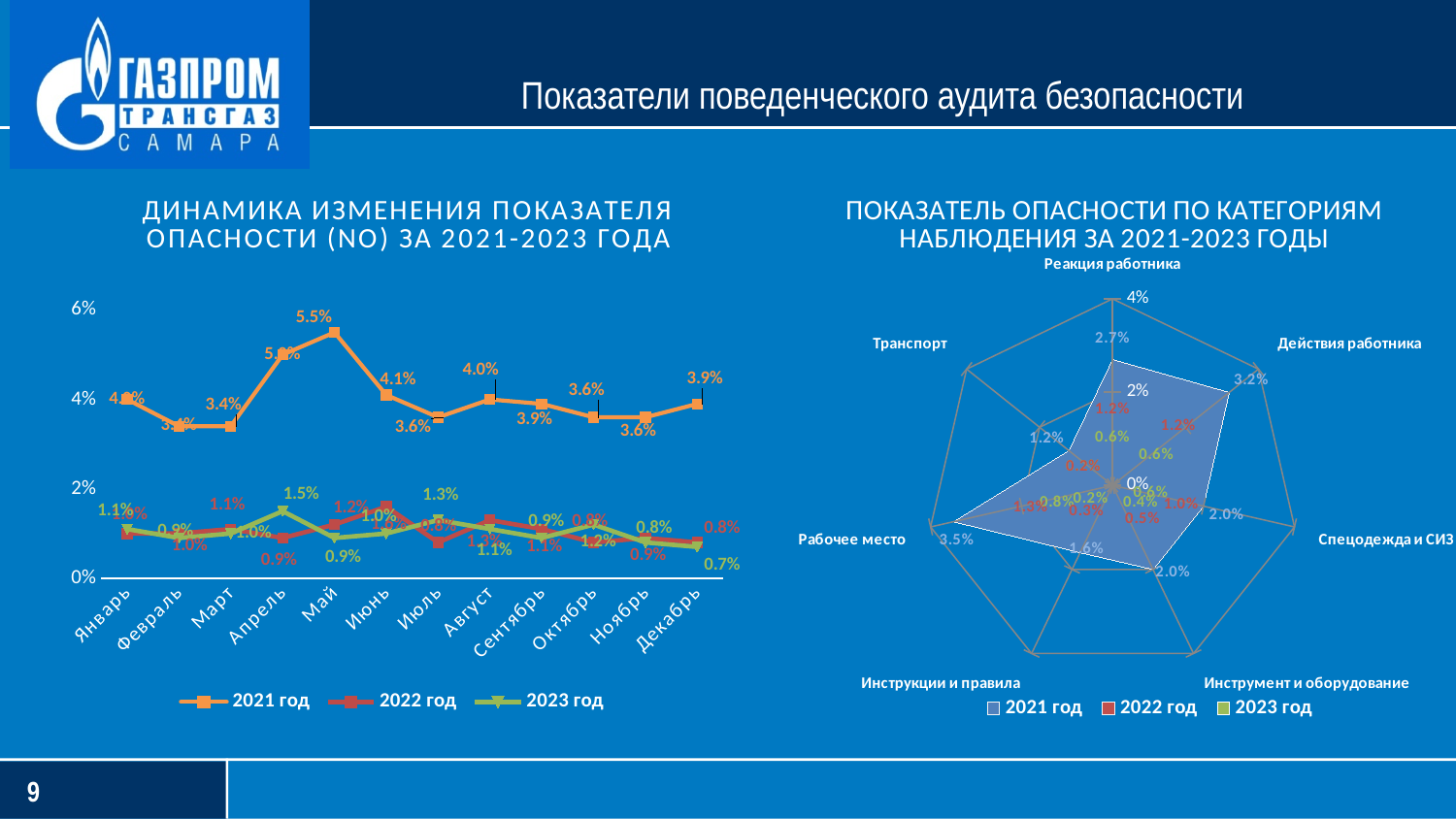
What kind of chart is the right chart, 'ПОКАЗАТЕЛЬ ОПАСНОСТИ ПО КАТЕГОРИЯМ НАБЛЮДЕНИЯ ЗА 2021-2023 ГОДЫ'? Radar chart In the left chart, in which month does the 2021 год series reach its highest value? Май In the left chart, how many series does the legend list? 3 In the left chart, what is the value for 2023 год in Декабрь? 0.7% In the right chart, how many observation categories are shown? 7 What kind of chart is the left chart, 'ДИНАМИКА ИЗМЕНЕНИЯ ПОКАЗАТЕЛЯ ОПАСНОСТИ (NO) ЗА 2021-2023 ГОДА'? Line chart In the left chart, what is the value for 2021 год in Май? 5.5% In the right chart, what is the 2021 год value for Рабочее место? 3.5% In the left chart, what is the value for 2023 год in Апрель? 1.5% In the right chart, which category has the highest 2021 год value? Рабочее место In the left chart, how many months are shown on the x axis? 12 In the left chart, what is the difference between the 2021 год values for Май (5.5%) and Июнь (4.1%)? 1.4 percentage points